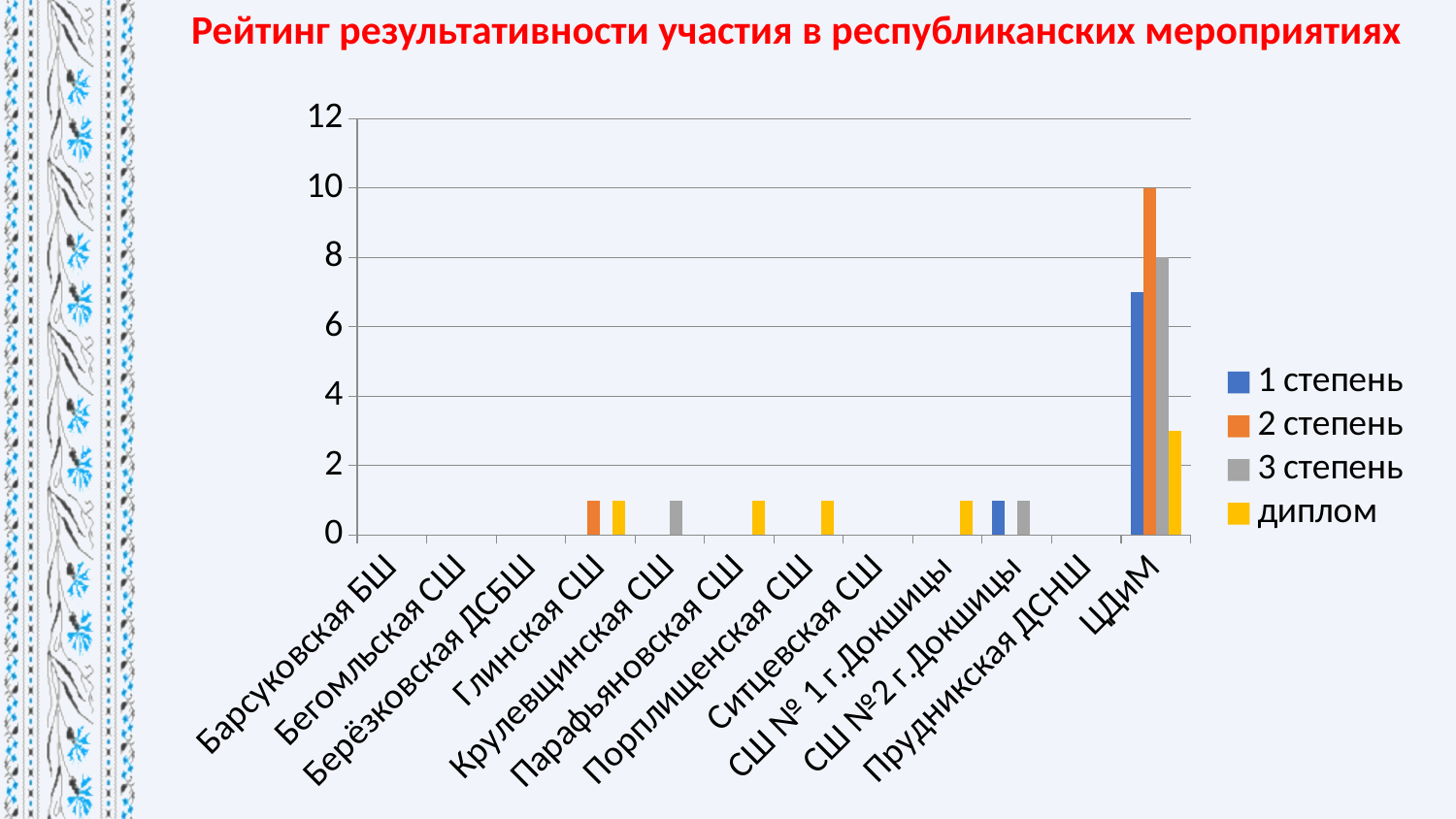
For ЦДиМ, what is the difference between the "2 степень" value and the "3 степень" value? 2 Which category has the highest value in the "2 степень" series? ЦДиМ What is the value of the "3 степень" series for ЦДиМ? 8 How many categories (schools) are shown on the x axis? 12 For ЦДиМ, which is larger: the "2 степень" value or the "3 степень" value? 2 степень What is the value of the "2 степень" series for ЦДиМ? 10 What kind of chart is shown on the slide? bar chart What is the title of the chart? Рейтинг результативности участия в республиканских мероприятиях Is the "диплом" value for Глинская СШ greater or less than 2? less Is the "диплом" value for ЦДиМ greater or less than 4? less How many series does the legend list? 4 Is the "1 степень" value for ЦДиМ greater or less than 6? greater